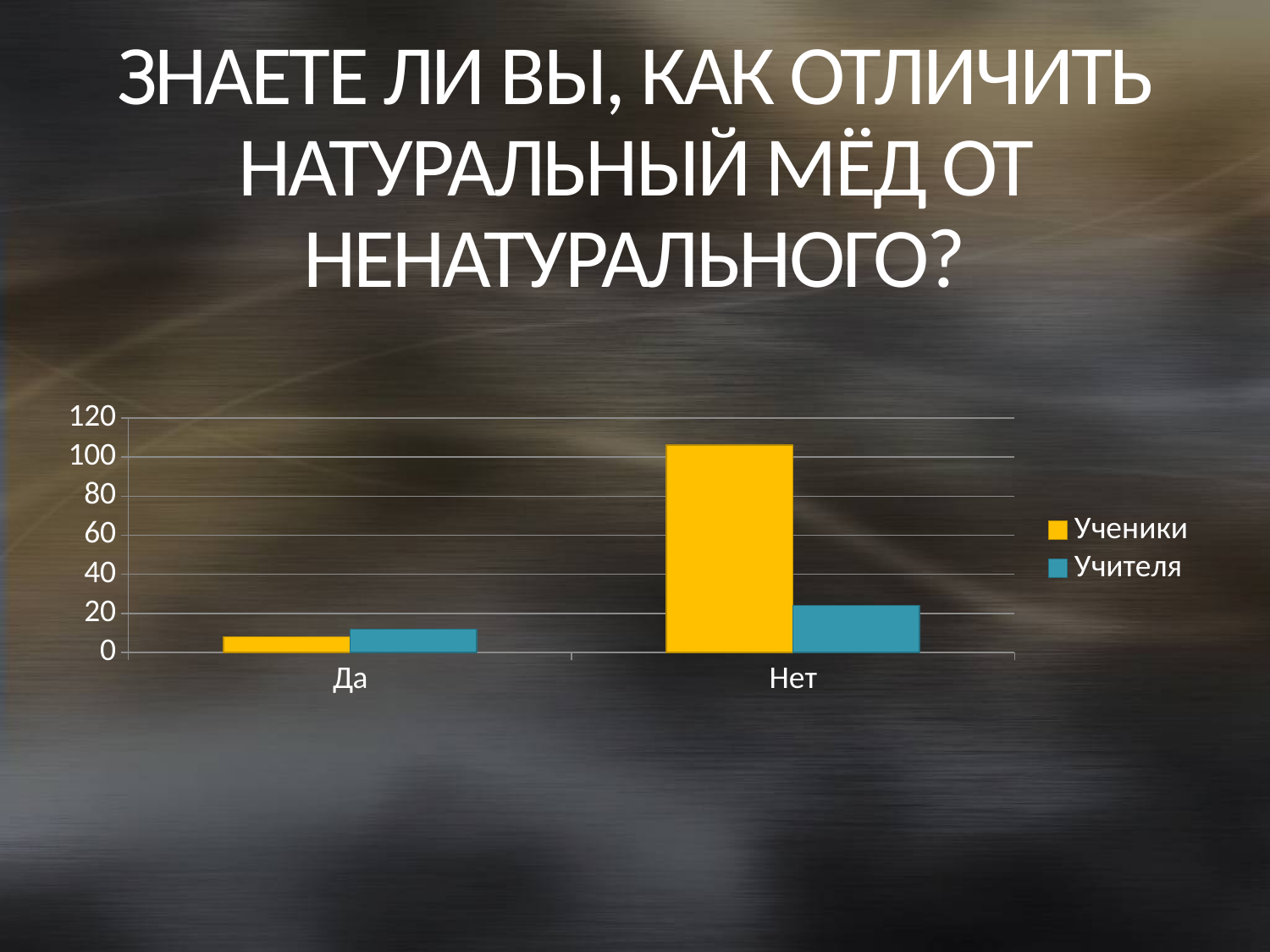
In the Да category, which series has the larger value, Ученики or Учителя? Учителя Is the value for Учителя in the Нет category greater or less than 20? greater What kind of chart is shown on the slide? bar chart In the Нет category, which series has the larger value, Ученики or Учителя? Ученики Is the value for Ученики in the Да category greater or less than 20? less Which category has the highest bar for Ученики? Нет How many series does the legend list? 2 How many categories are shown on the x axis? 2 Which series is shown in yellow in the legend? Ученики Which category has the lowest bar for Учителя? Да Is the value for Учителя in the Нет category greater or less than 40? less